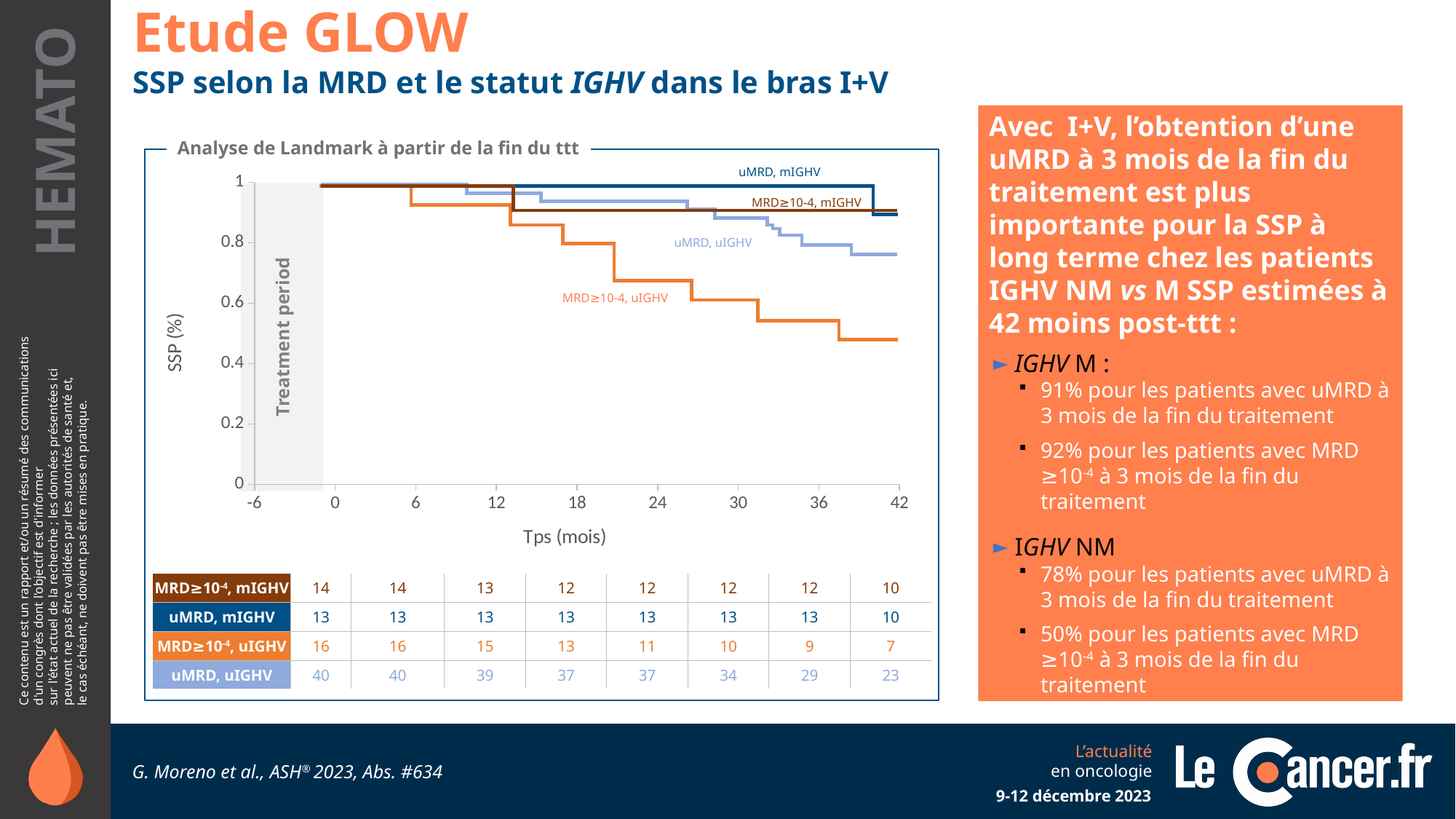
Is the SSP value for the MRD≥10-4, uIGHV curve at 42 months greater or less than 0.6? less In the number-at-risk table, how many patients are at risk in the uMRD, uIGHV group at 0 months? 40 In the number-at-risk table, what is the difference between the uMRD, uIGHV count at 0 months and at 42 months? 17 How many curves (series) are plotted on the chart? 4 Do the curves rise or fall as time (Tps) increases along the x axis? fall In the number-at-risk table, how many patients are at risk in the uMRD, mIGHV group at 36 months? 13 Is the SSP value for the uMRD, mIGHV curve at 42 months greater or less than 0.8? greater Which curve is the lowest at 42 months? MRD≥10-4, uIGHV What is the label of the x axis of the chart? Tps (mois) In the number-at-risk table, how many patients are at risk in the MRD≥10-4, uIGHV group at 42 months? 7 What kind of chart is shown on the slide? line chart At 42 months, which group has more patients at risk: uMRD, mIGHV or MRD≥10-4, uIGHV? uMRD, mIGHV